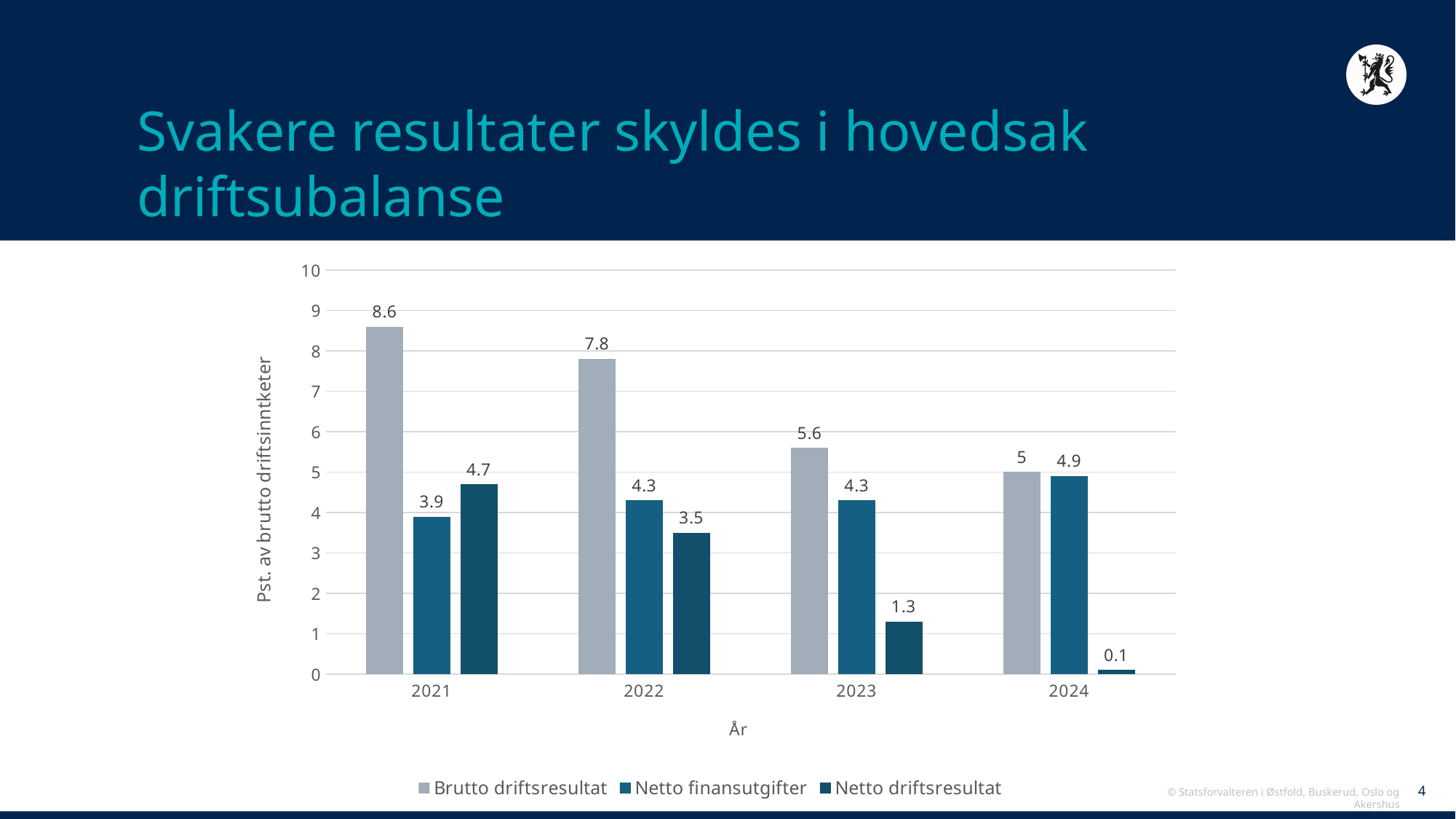
What is the difference between Brutto driftsresultat and Netto driftsresultat in 2023? 4.3 Does Brutto driftsresultat rise or fall from 2021 to 2024? Fall Which is larger in 2024, Brutto driftsresultat or Netto finansutgifter? Brutto driftsresultat How many series does the legend list? 3 In which year is Netto driftsresultat lowest? 2024 What is the label of the y axis? Pst. av brutto driftsinntkter What kind of chart is shown on the slide? Bar chart What is the value of Brutto driftsresultat in 2021? 8.6 What is the value of Netto finansutgifter in 2022? 4.3 What is the value of Netto driftsresultat in 2024? 0.1 How many years are shown on the x axis? 4 In which year is Brutto driftsresultat highest? 2021